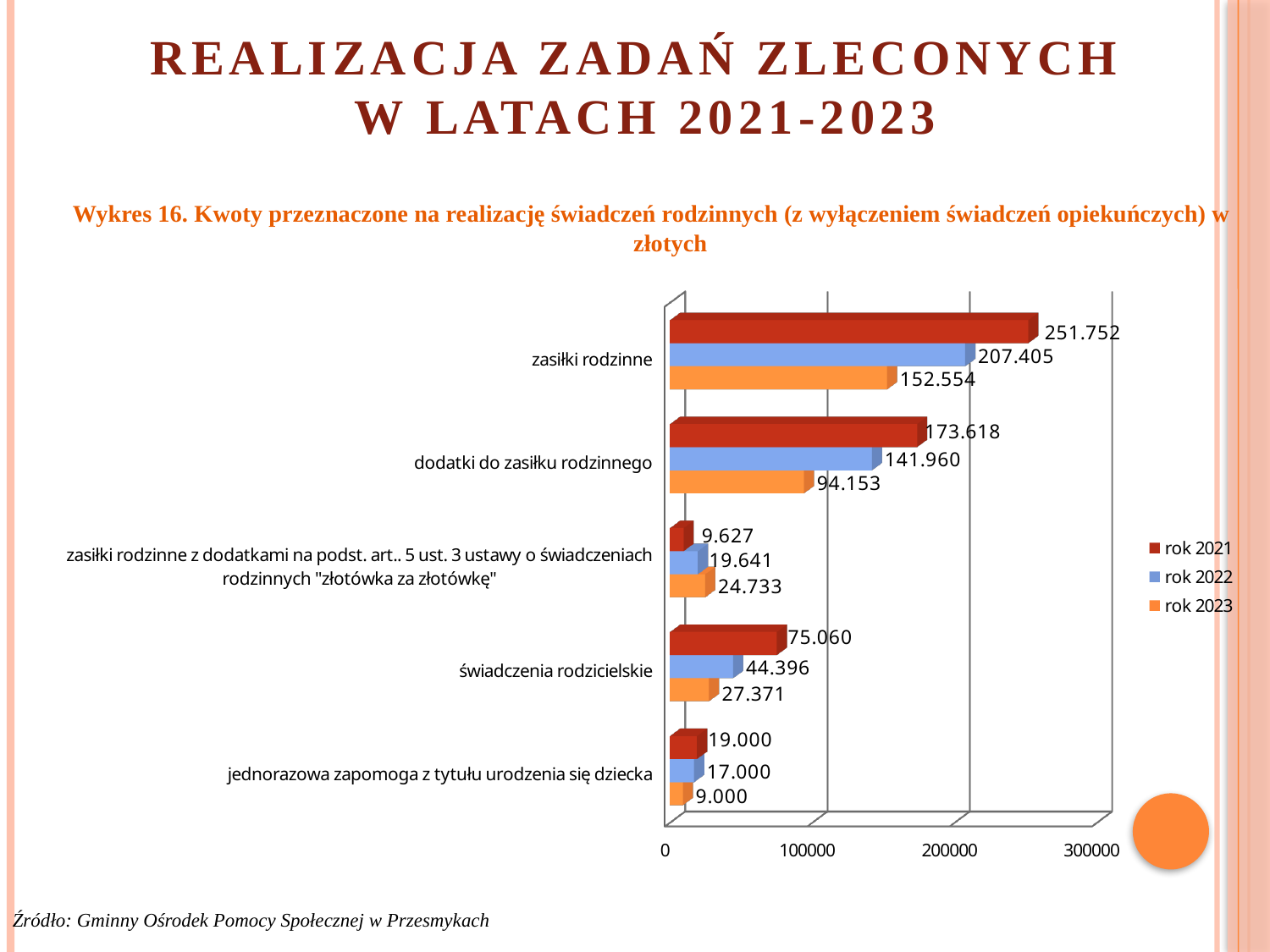
How many series does the legend list? 3 Which category has the highest value in rok 2021? zasiłki rodzinne What is the difference between the rok 2021 and rok 2023 values for dodatki do zasiłku rodzinnego? 79.465 What is the value for jednorazowa zapomoga z tytułu urodzenia się dziecka in rok 2023? 9.000 What is the value for dodatki do zasiłku rodzinnego in rok 2023? 94.153 What is the value for świadczenia rodzicielskie in rok 2022? 44.396 Which is larger for świadczenia rodzicielskie: the rok 2021 value or the rok 2023 value? rok 2021 What is the difference between the rok 2021 and rok 2022 values for zasiłki rodzinne? 44.347 How many categories are shown on the chart? 5 What is the value for zasiłki rodzinne in rok 2021? 251.752 Which category has the lowest value in rok 2023? jednorazowa zapomoga z tytułu urodzenia się dziecka What kind of chart is shown on the slide? bar chart